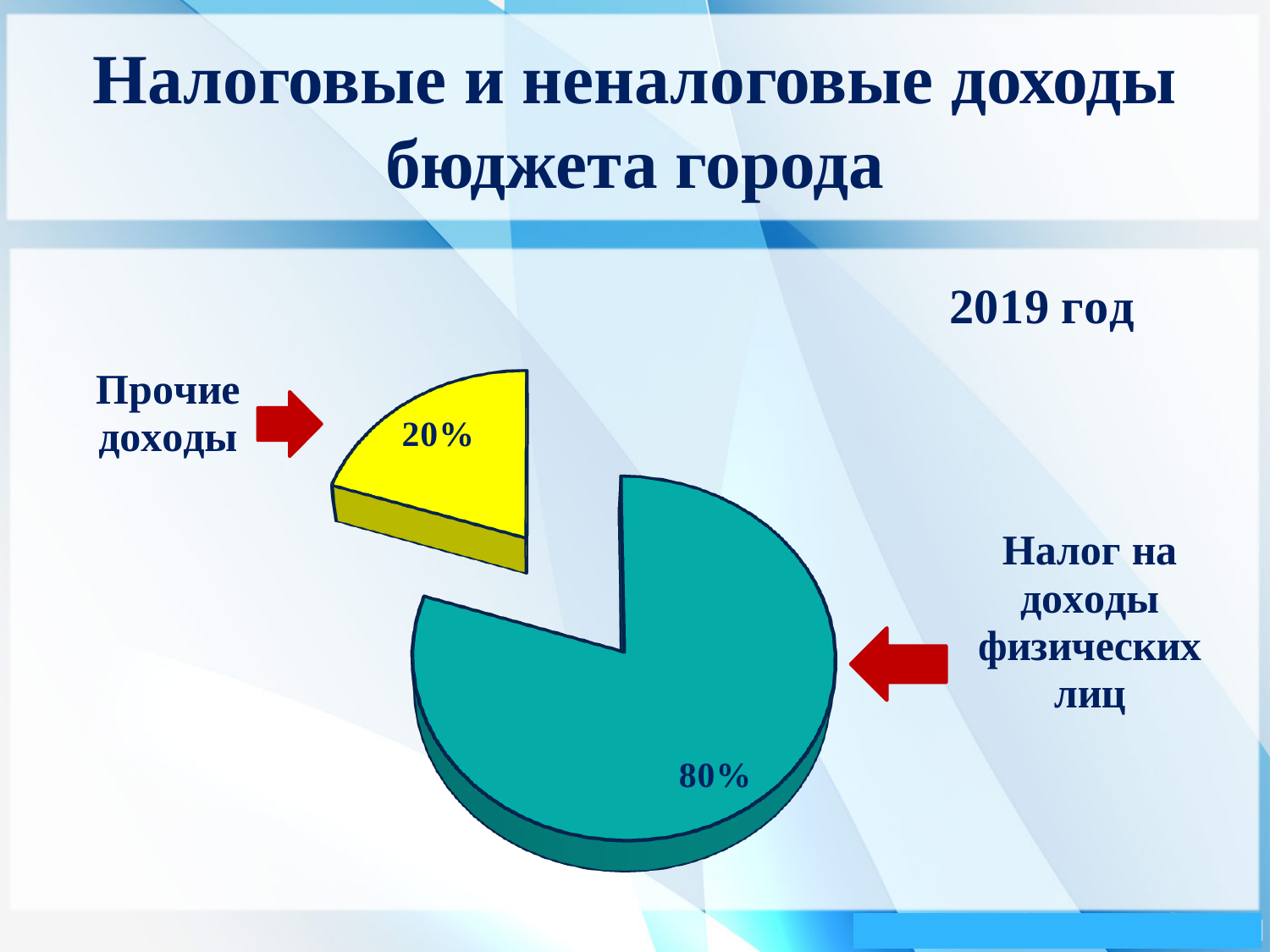
Which is larger: the share of "Прочие доходы" or the share of "Налог на доходы физических лиц"? Налог на доходы физических лиц How many slices does the pie chart have? 2 Which category has the smallest share of the pie? Прочие доходы What year does the chart refer to? 2019 год What share of the pie does "Прочие доходы" represent? 20% Which category has the largest share of the pie? Налог на доходы физических лиц What kind of chart is shown on the slide? pie chart What colour is the slice for "Прочие доходы"? yellow What share of the pie does "Налог на доходы физических лиц" represent? 80% What is the difference in percentage points between the share of "Налог на доходы физических лиц" and "Прочие доходы"? 60